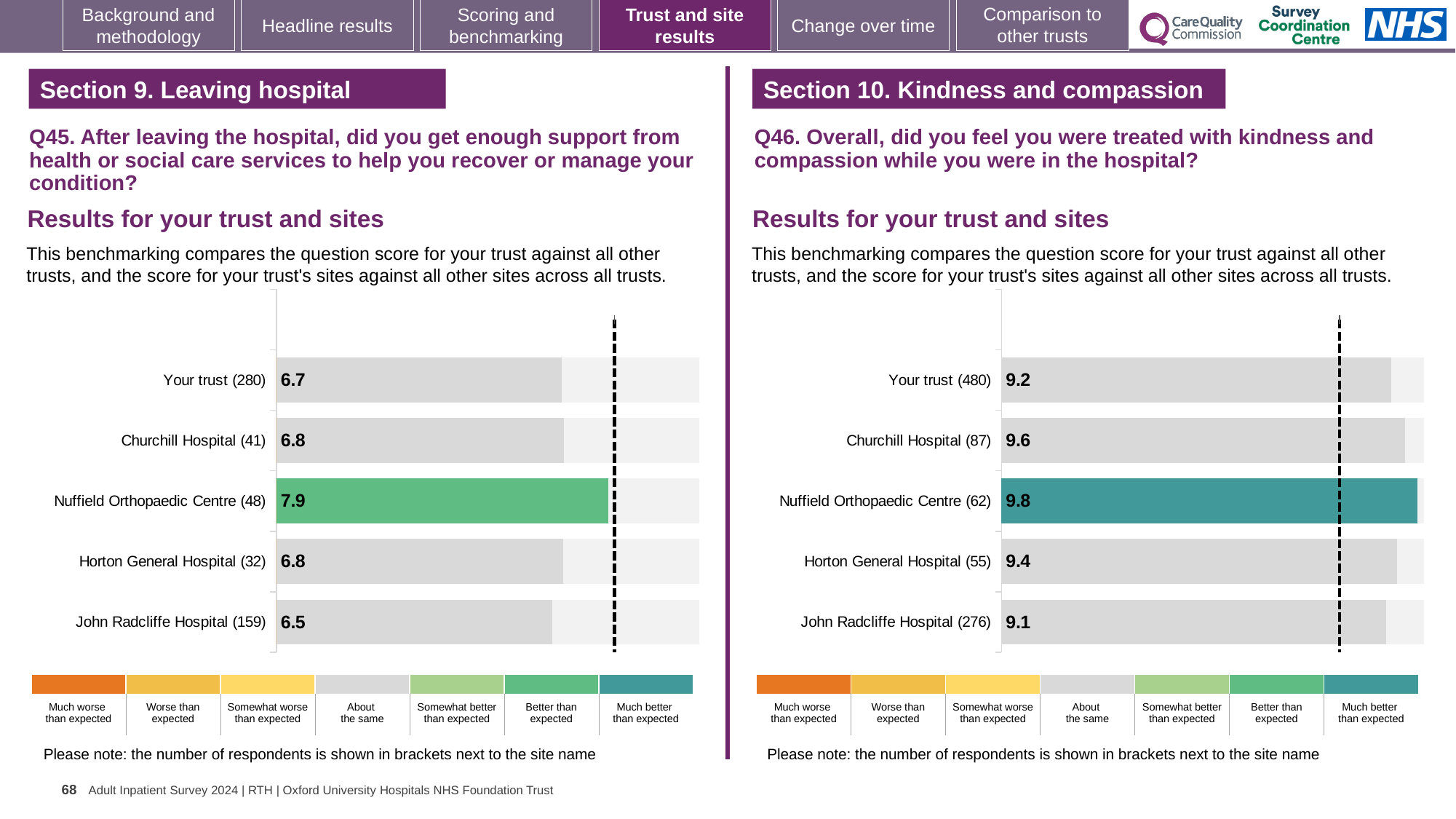
In the Q45 chart on the left, how many bars are plotted? 5 In the Q45 chart on the left, what is the difference between the scores for Nuffield Orthopaedic Centre and Your trust? 1.2 In the Q46 chart on the right, what is the score for Your trust? 9.2 What kind of chart is used for the Q45 results on the left? Bar chart In the Q45 chart on the left, what is the score for John Radcliffe Hospital? 6.5 In the Q45 chart on the left, which site has the lowest score? John Radcliffe Hospital In the Q45 chart on the left, what is the score for Nuffield Orthopaedic Centre? 7.9 In the Q46 chart on the right, what is the score for Horton General Hospital? 9.4 In the Q46 chart on the right, how many respondents are shown in brackets for Your trust? 480 In the Q46 chart on the right, what is the difference between the scores for Churchill Hospital and John Radcliffe Hospital? 0.5 In the Q46 chart on the right, which site has the highest score? Nuffield Orthopaedic Centre In the Q46 chart on the right, which has the higher score, Churchill Hospital or John Radcliffe Hospital? Churchill Hospital